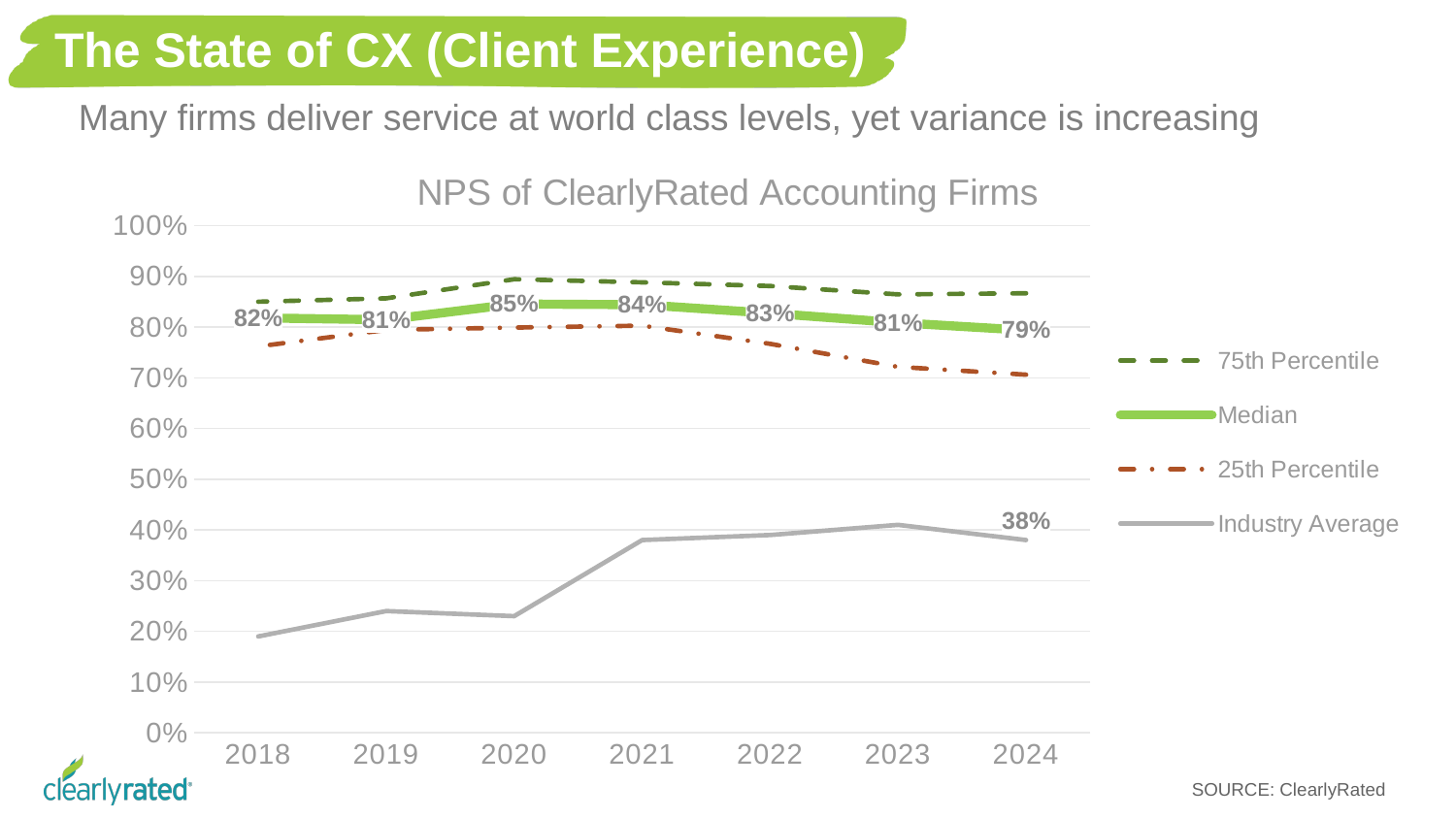
What is the difference between the Median NPS in 2020 and in 2024? 6% In which year is the Median NPS highest? 2020 In which year is the Median NPS lowest? 2024 How many series does the legend list? 4 What is the Median NPS value for 2024? 79% Which is larger, the Median NPS in 2018 or in 2019? 2018 What type of chart is shown? Line chart What is the Median NPS value for 2020? 85% Is the 25th Percentile value for 2024 greater or less than 80%? less What is the Industry Average value shown for 2024? 38% How many years are shown on the x axis? 7